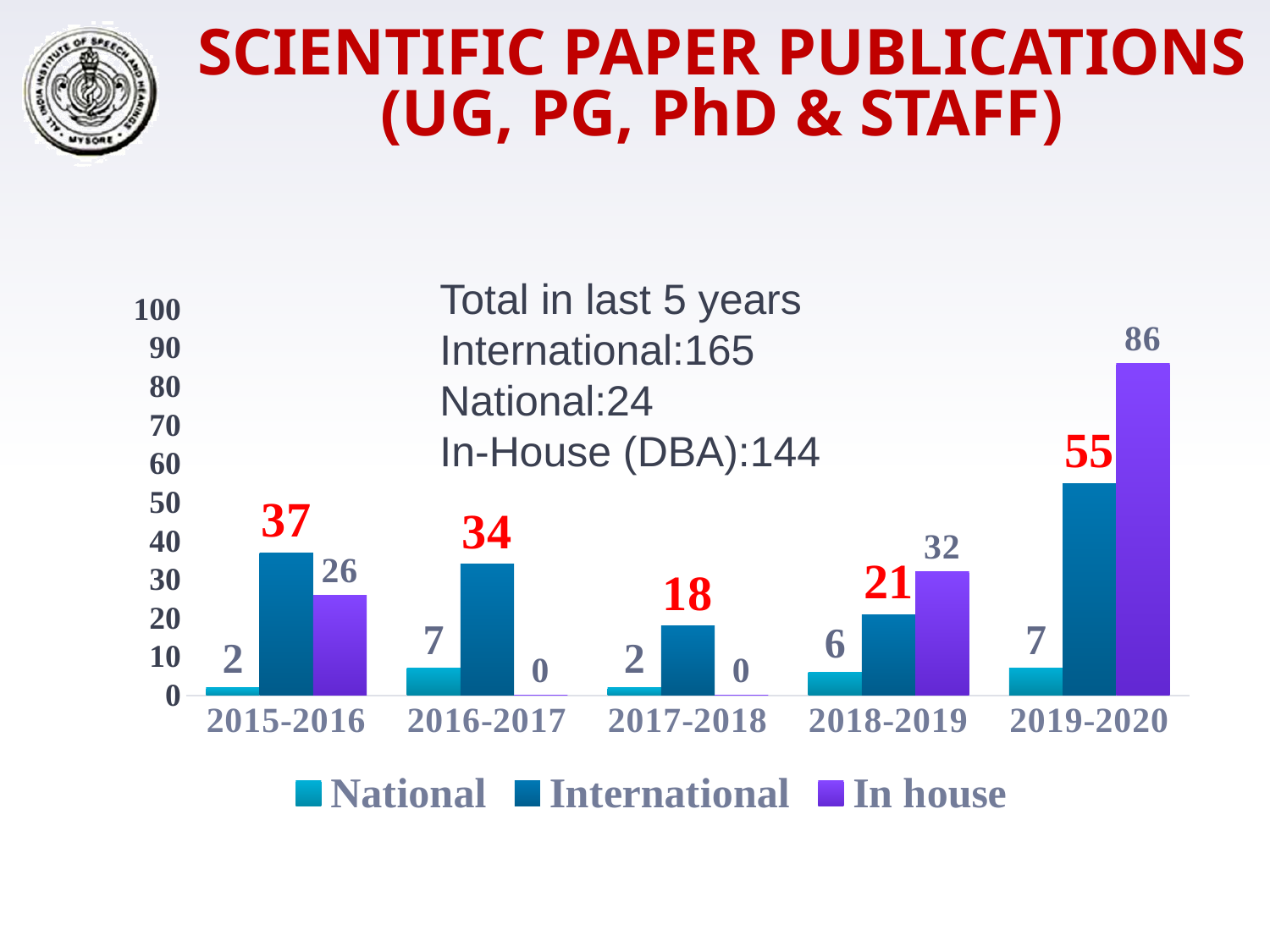
What is the In house value for 2015-2016? 26 Which is larger for 2015-2016, the International value or the In house value? International What is the National value for 2016-2017? 7 Does the In house value rise or fall from 2018-2019 to 2019-2020? rise How many series does the legend list? 3 What kind of chart is shown on the slide? bar chart How many year categories are shown on the x axis? 5 What total for International publications in the last 5 years is stated on the slide? 165 Which year has the lowest International value? 2017-2018 What is the difference between the In house value and the International value for 2019-2020? 31 What is the International value for 2019-2020? 55 Which year has the highest In house value? 2019-2020